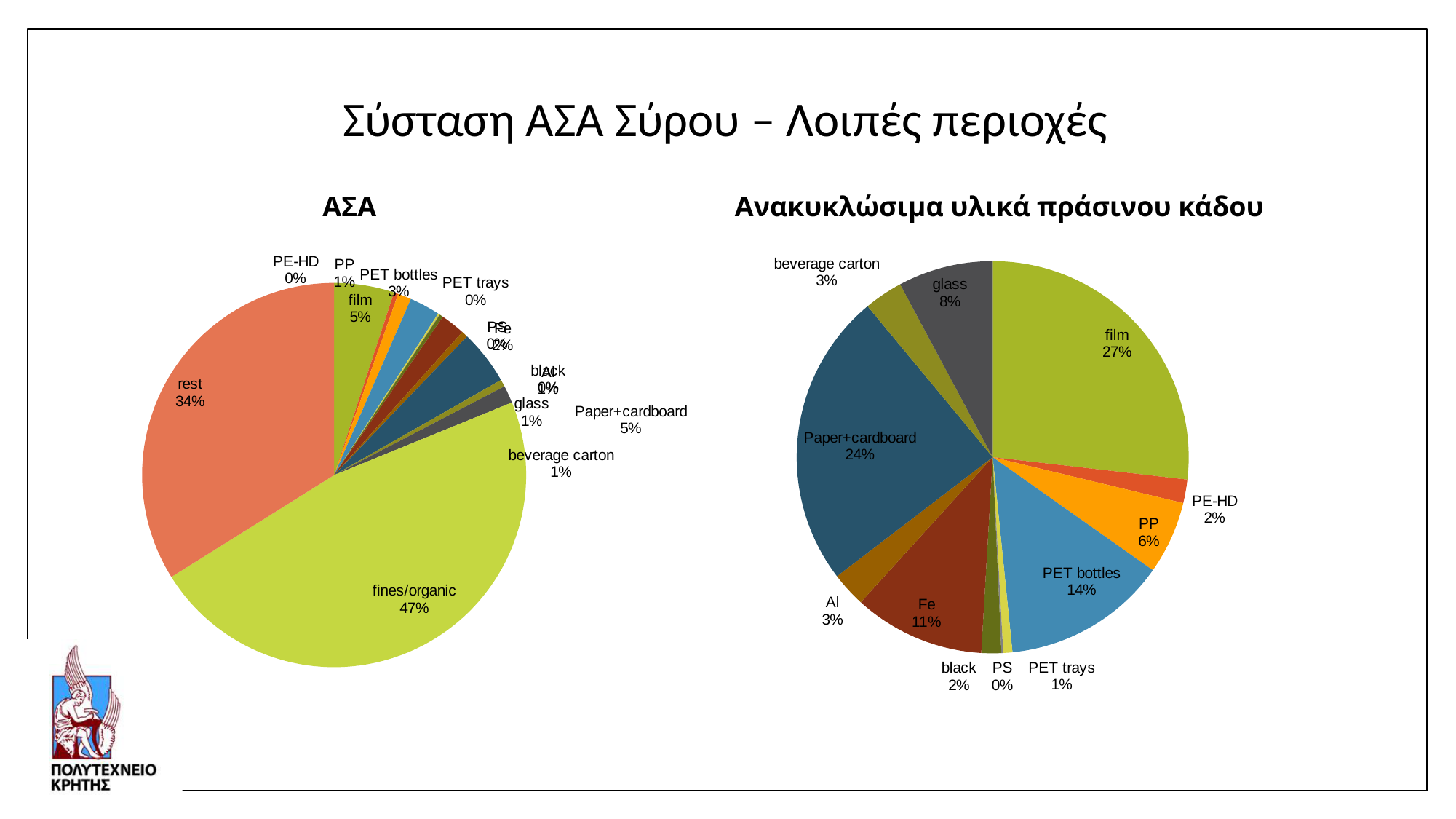
In the Ανακυκλώσιμα υλικά πράσινου κάδου pie chart, which category has the largest share? film In the ΑΣΑ pie chart, which category has the largest share? fines/organic What type of chart is used for ΑΣΑ on the left of the slide? pie chart In the Ανακυκλώσιμα υλικά πράσινου κάδου pie chart, what share is film? 27% In the ΑΣΑ pie chart, what share is fines/organic? 47% In the Ανακυκλώσιμα υλικά πράσινου κάδου pie chart, what share is Paper+cardboard? 24% How many categories are shown in the Ανακυκλώσιμα υλικά πράσινου κάδου pie chart? 12 In the ΑΣΑ pie chart, what is the difference between the fines/organic share and the rest share? 13% In the ΑΣΑ pie chart, what share is rest? 34% In the Ανακυκλώσιμα υλικά πράσινου κάδου pie chart, which is larger, PET bottles or Fe? PET bottles In the ΑΣΑ pie chart, what share is Paper+cardboard? 5% In the Ανακυκλώσιμα υλικά πράσινου κάδου pie chart, what is the difference between the film share and the Paper+cardboard share? 3%